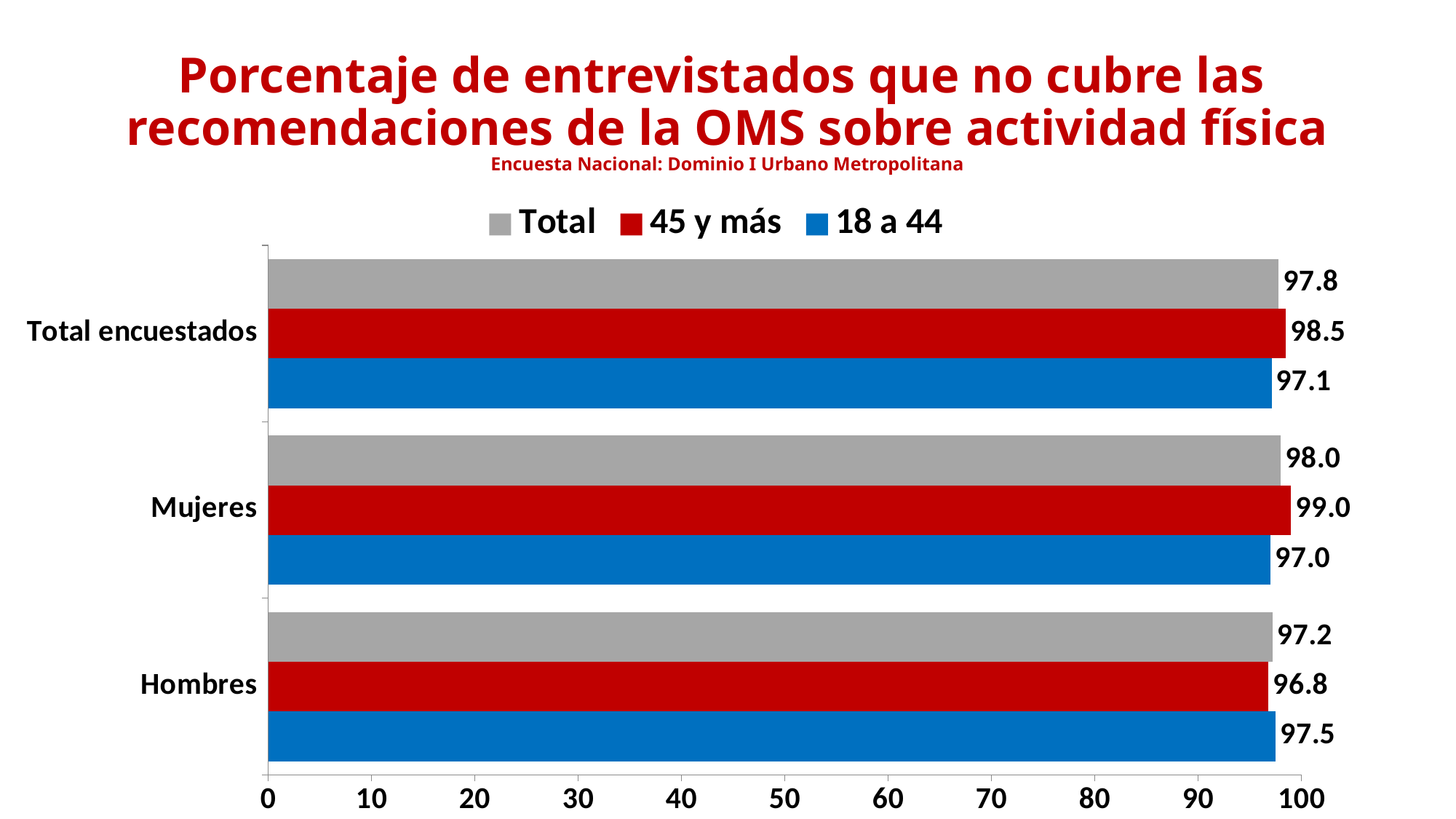
Which category has the lowest value for the '45 y más' series? Hombres What is the value for '18 a 44' in the 'Hombres' category? 97.5 How many categories are shown on the y axis? 3 Is the '18 a 44' value for 'Mujeres' greater or less than 90? greater What is the difference between the '45 y más' and '18 a 44' values for 'Mujeres'? 2.0 Which category has the highest value for the '45 y más' series? Mujeres Which colour represents the '18 a 44' series in the legend? Blue What kind of chart is shown on the slide? Bar chart How many series does the legend list? 3 What is the value for '45 y más' in the 'Mujeres' category? 99.0 For 'Hombres', which is larger: the '45 y más' value or the '18 a 44' value? 18 a 44 What is the 'Total' value for 'Total encuestados'? 97.8